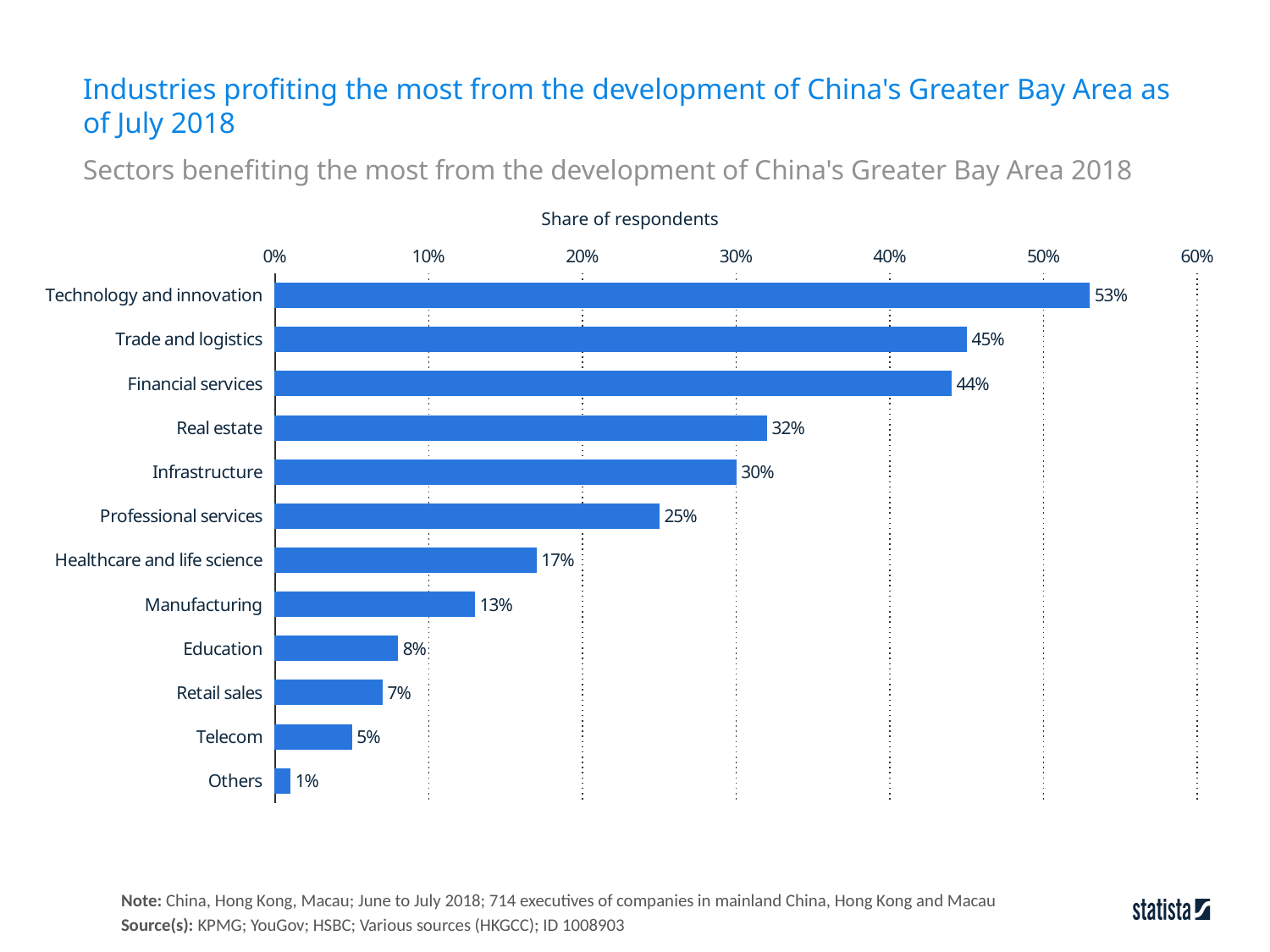
What is the label of the horizontal axis? Share of respondents What share of respondents named Technology and innovation? 53% Which category has the lowest share of respondents? Others How many industries are shown in the chart? 12 What share of respondents is shown for Telecom? 5% How much higher is Real estate than Manufacturing? 19% Which is larger, Infrastructure or Professional services? Infrastructure Is the value for Education greater or less than 10%? less What kind of chart is shown on the slide? Bar chart What is the value for Healthcare and life science? 17% What is the difference between Trade and logistics and Financial services? 1% Which industry has the highest share of respondents? Technology and innovation